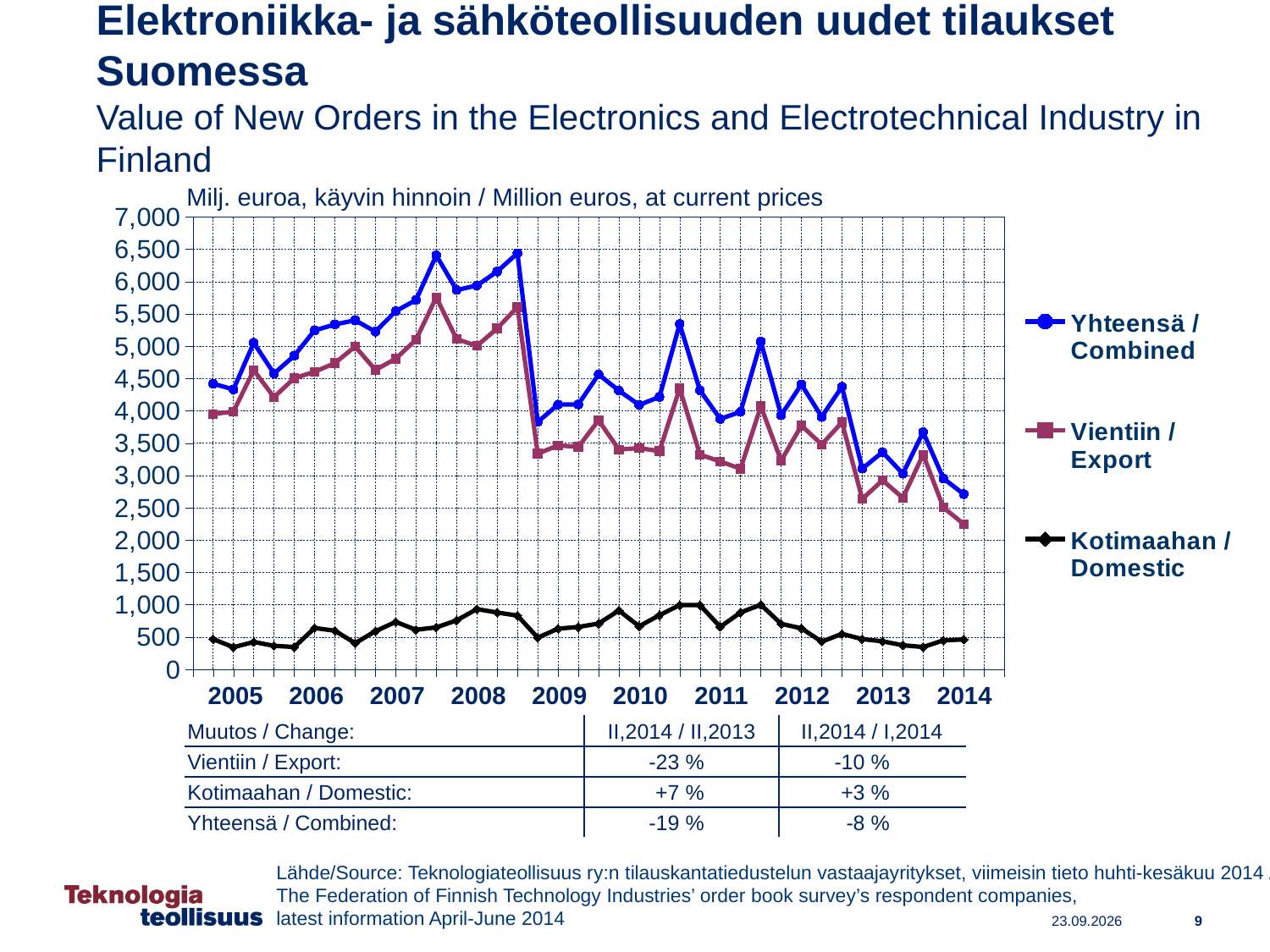
What kind of chart is shown on the slide? line chart Which series is shown with the blue line in the chart? Yhteensä / Combined Is the peak value of the Yhteensä / Combined series in 2008 greater or less than 6,000? greater In 2010, which series has larger values, Vientiin / Export or Kotimaahan / Domestic? Vientiin / Export How many series does the chart legend list? 3 How many years are labelled on the x axis of the chart? 10 Do the values of the Yhteensä / Combined series rise or fall from 2011 to 2014? fall Which series has the lowest values throughout the chart? Kotimaahan / Domestic Is the last plotted value of the Yhteensä / Combined series in 2014 greater or less than 3,000? less Is the last plotted value of the Vientiin / Export series in 2014 greater or less than 2,500? less What unit is stated above the chart for the plotted values? Milj. euroa, käyvin hinnoin / Million euros, at current prices Which series has the highest values throughout the chart? Yhteensä / Combined